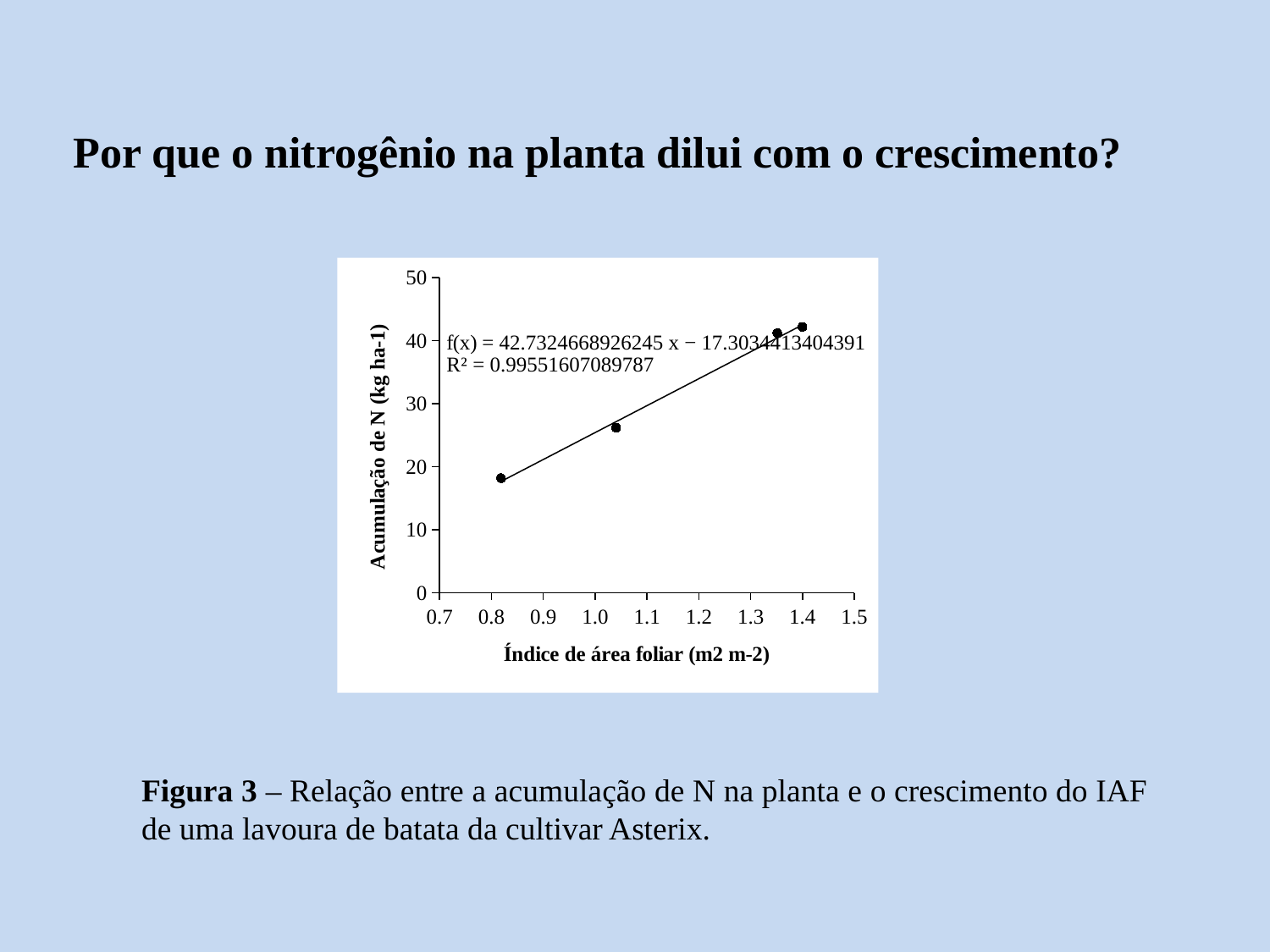
Is the N accumulation value for the rightmost data point (highest leaf area index) greater or less than 30? greater Is the N accumulation value for the leftmost data point (lowest leaf area index) greater or less than 20? less Which data point has the lowest N accumulation: the one with the lowest leaf area index or the one with the highest leaf area index? the one with the lowest leaf area index How many data points are plotted in the chart? 4 What is the title of the y axis of the chart? Acumulação de N (kg ha-1) Does N accumulation rise or fall as the leaf area index increases along the x axis? rise Is the N accumulation value for the data point near a leaf area index of 1.04 greater or less than 20? greater What is the R² value printed on the chart? 0.99551607089787 What kind of chart is shown on the slide? scatter chart